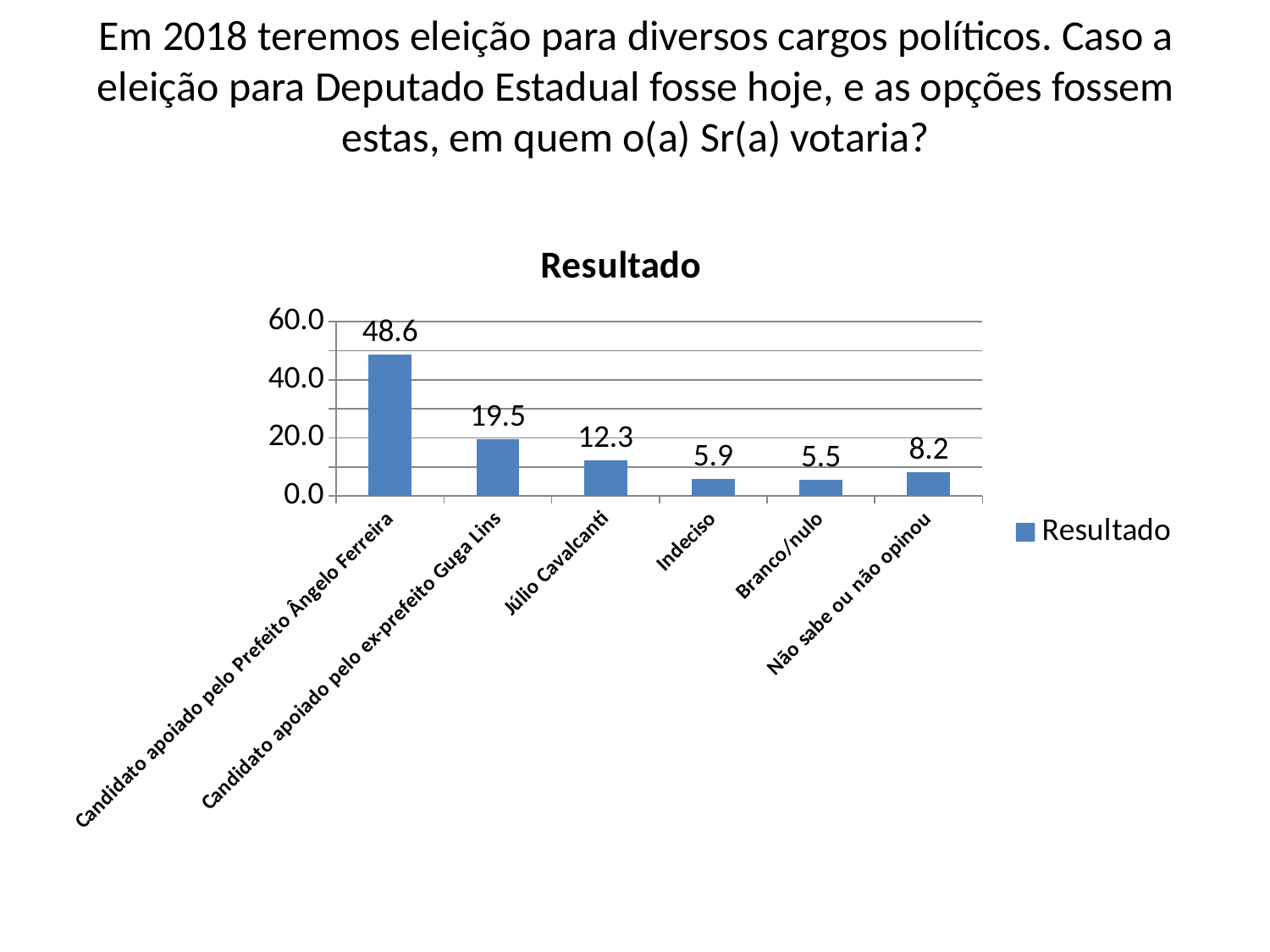
Which category has the highest value? Candidato apoiado pelo Prefeito Ângelo Ferreira Which is larger, the value for Indeciso or the value for Não sabe ou não opinou? Não sabe ou não opinou What is the value for Júlio Cavalcanti? 12.3 Is the value for Candidato apoiado pelo Prefeito Ângelo Ferreira greater or less than 40.0? greater What is the value for Não sabe ou não opinou? 8.2 What kind of chart is shown? bar chart Which category has the lowest value? Branco/nulo How many categories are shown on the x axis? 6 How many series does the legend list? 1 What is the difference between the values for Candidato apoiado pelo Prefeito Ângelo Ferreira and Candidato apoiado pelo ex-prefeito Guga Lins? 29.1 What is the value for Candidato apoiado pelo ex-prefeito Guga Lins? 19.5 What is the title of the chart? Resultado